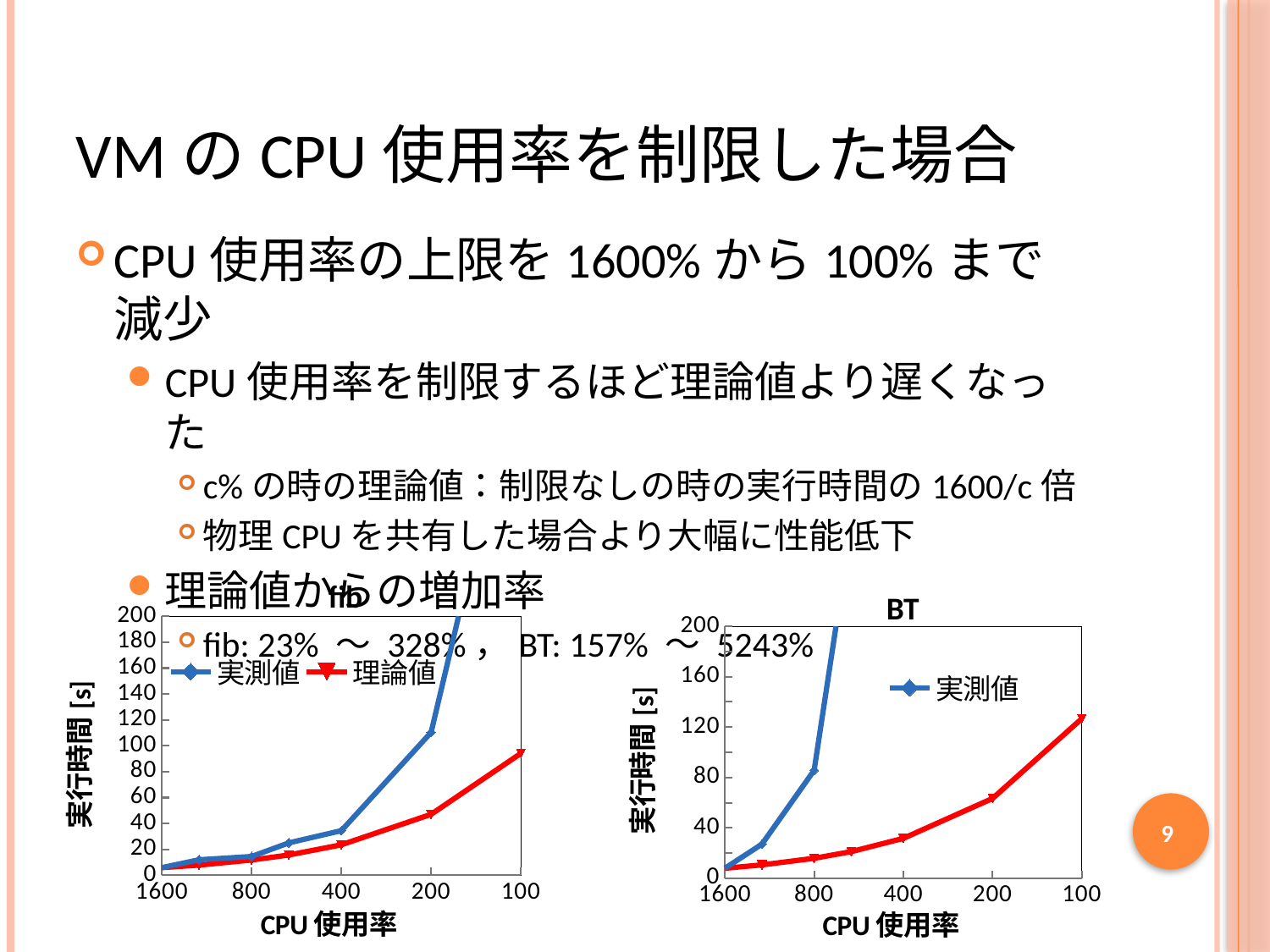
In the BT chart, is the 実測値 value at CPU使用率 800 greater or less than 40? greater In the fib chart, how many series does the legend list? 2 In the fib chart, is the 実測値 value at CPU使用率 200 greater or less than 100? greater In the fib chart, is the 理論値 value at CPU使用率 200 greater or less than 60? less How many labeled CPU使用率 tick values are shown on the x axis of the fib chart? 5 In the fib chart, at CPU使用率 200, which series has the larger value, 実測値 or 理論値? 実測値 What is the title of the right chart? BT In the fib chart, what are the two series named in the legend? 実測値 and 理論値 What kind of chart is the left chart titled fib? line chart In the BT chart, do the 実測値 values rise or fall moving left to right along the x axis from 1600 toward 100? rise